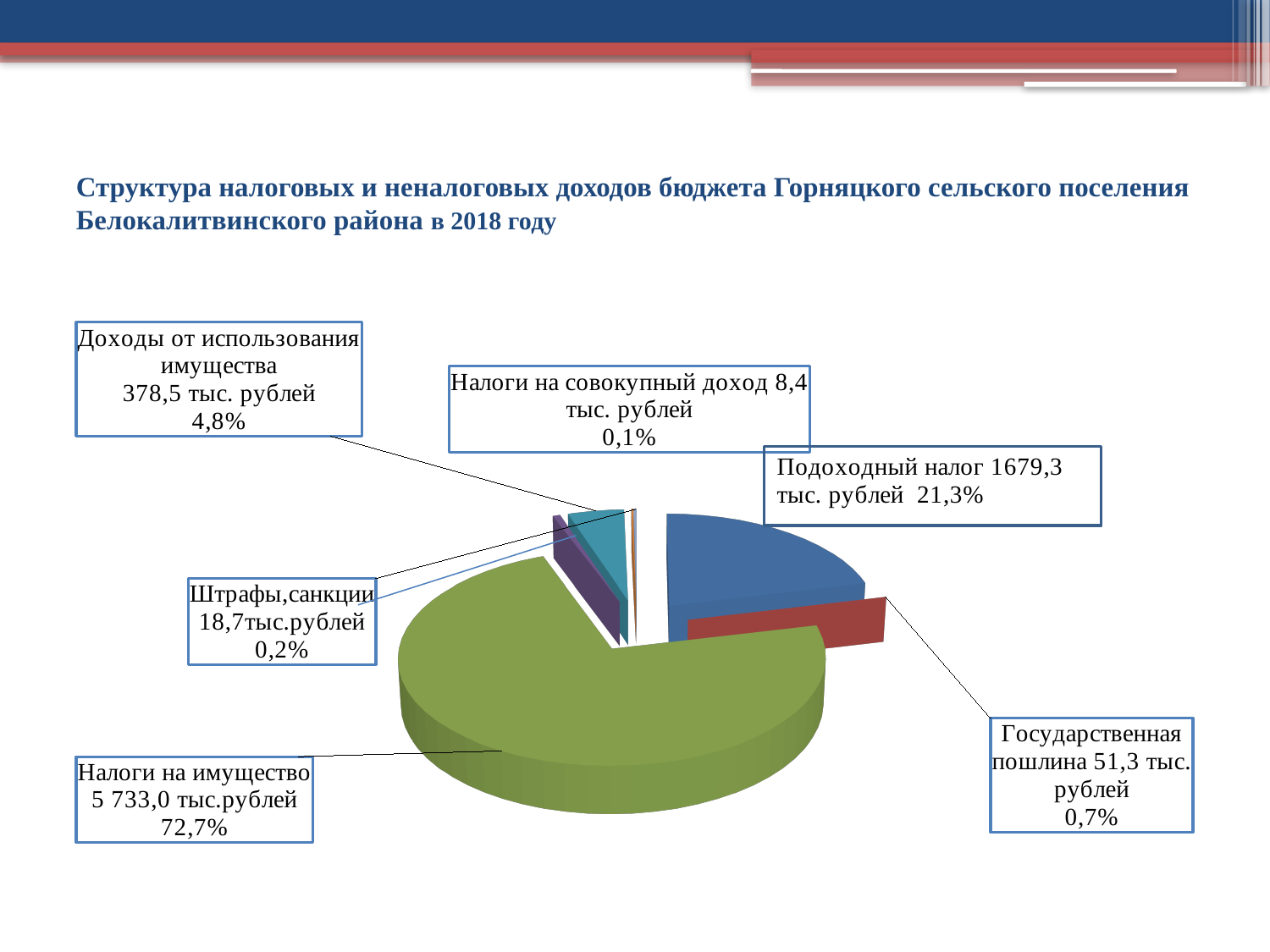
Which is larger, the share for Подоходный налог or the share for Доходы от использования имущества? Подоходный налог Which year does the chart title say the data refers to? 2018 What is the difference in percentage points between the share of Налоги на имущество and the share of Подоходный налог? 51,4% What is the value for Государственная пошлина? 51,3 тыс. рублей What kind of chart is shown on the slide? Pie chart What is the value for Подоходный налог? 1679,3 тыс. рублей Which category has the smallest share of the pie? Налоги на совокупный доход What is the value for Штрафы,санкции? 18,7 тыс. рублей What share of the pie does Доходы от использования имущества represent? 4,8% What share of the pie does Налоги на имущество represent? 72,7% Which category has the largest share of the pie? Налоги на имущество